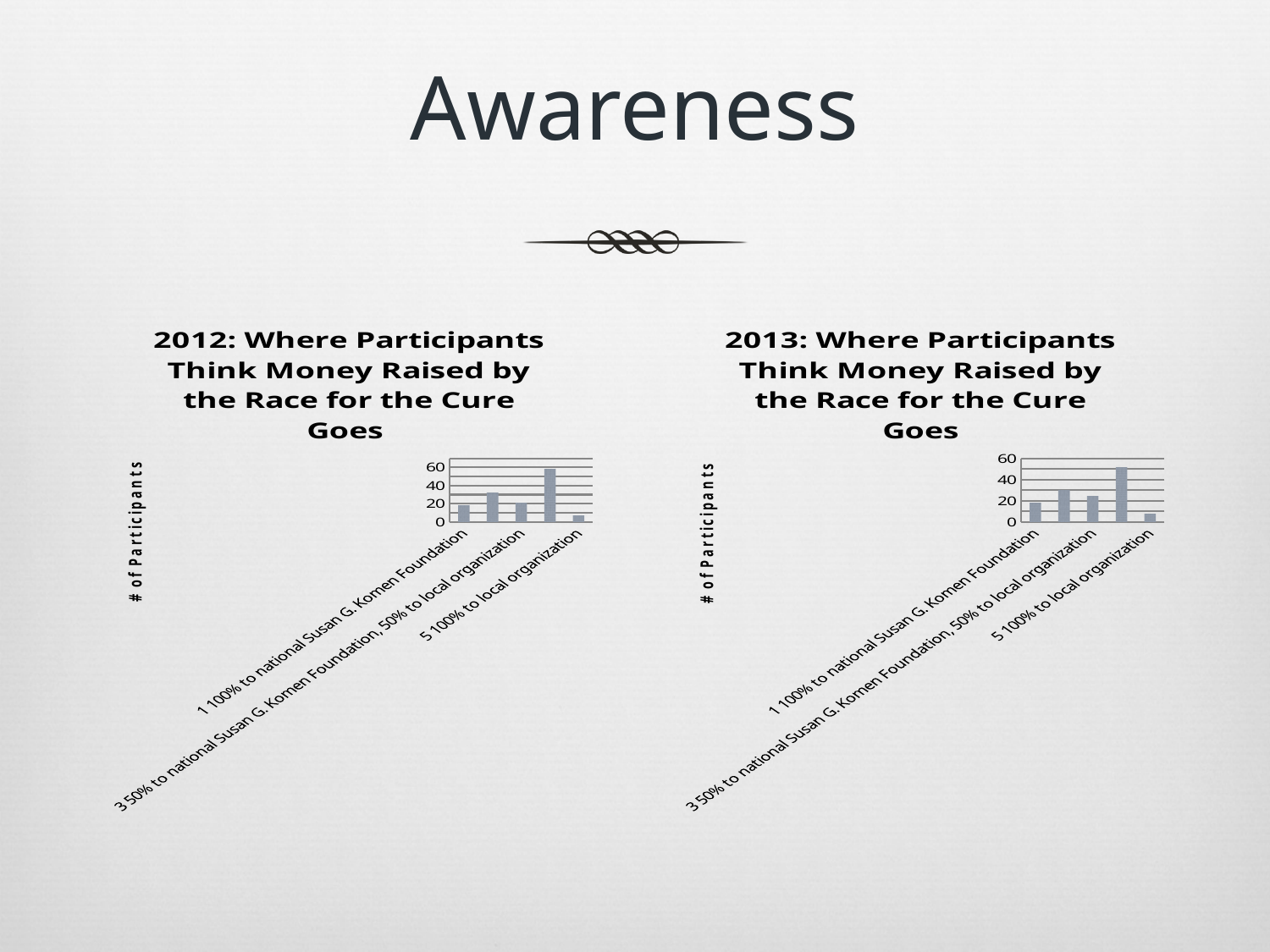
What is the title of the chart on the right? 2013: Where Participants Think Money Raised by the Race for the Cure Goes What is the y-axis title of the 2012 chart on the left? # of Participants In the 2012 chart, is the value for '5 100% to local organization' greater or less than 20? less In the 2013 chart, which labelled category has the lowest number of participants? 5 100% to local organization In the 2012 chart, which is larger: the value for '1 100% to national Susan G. Komen Foundation' or the value for '5 100% to local organization'? 1 100% to national Susan G. Komen Foundation How many bars are plotted in the 2013 chart on the right? 5 In the 2013 chart, is the value for '3 50% to national Susan G. Komen Foundation, 50% to local organization' greater or less than 20? greater What kind of chart is the 2012 chart on the left? bar chart In the 2012 chart, which labelled category has the lowest number of participants? 5 100% to local organization In the 2013 chart, which is larger: the value for '3 50% to national Susan G. Komen Foundation, 50% to local organization' or the value for '1 100% to national Susan G. Komen Foundation'? 3 50% to national Susan G. Komen Foundation, 50% to local organization In the 2013 chart, is the value for '5 100% to local organization' greater or less than 20? less